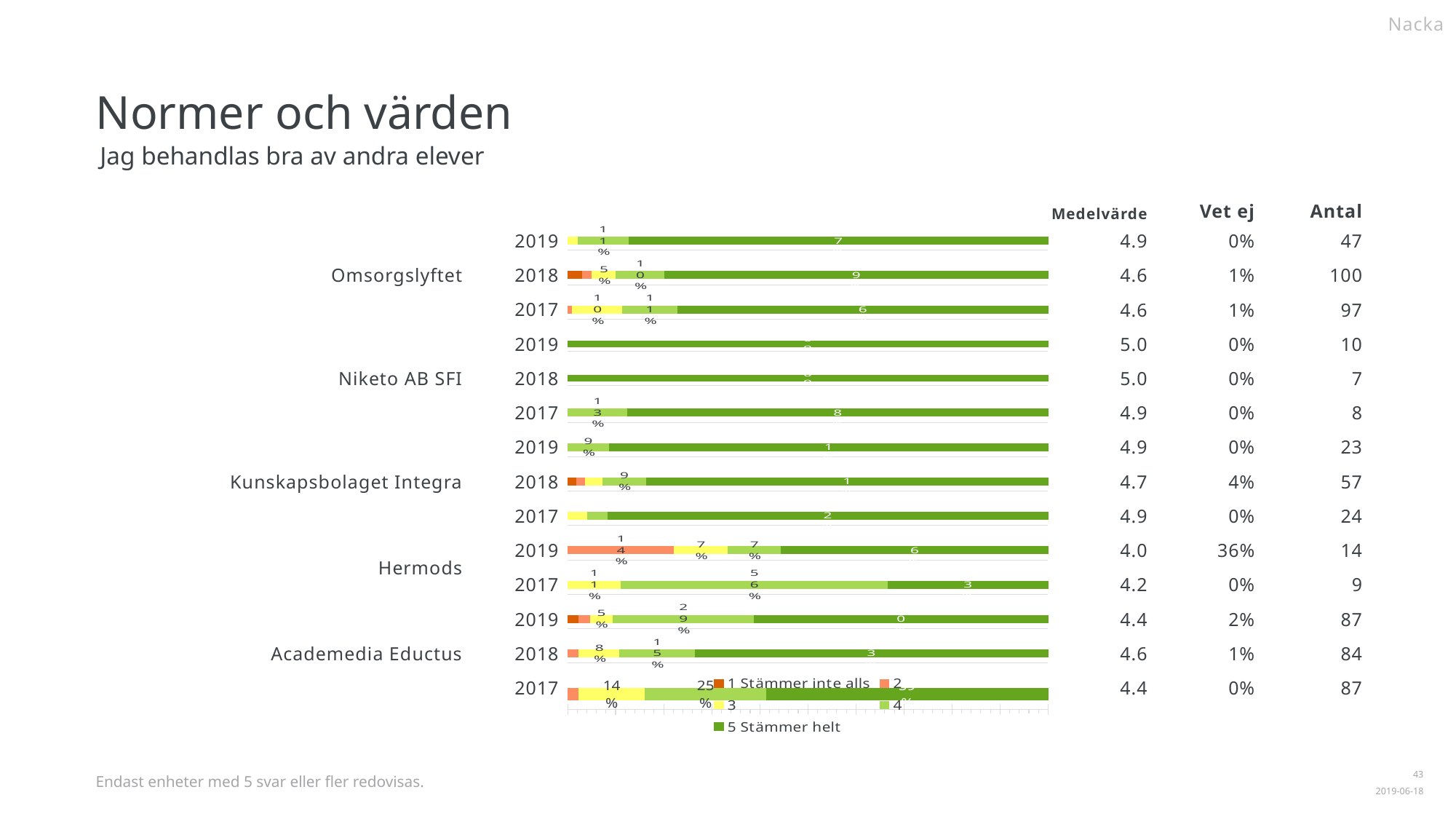
Which is larger: the '4' segment for Hermods 2017 or the '4' segment for Academedia Eductus 2017? Hermods 2017 What is the value of the '4' segment for Academedia Eductus 2019? 29% How many series does the chart legend list? 5 What is the value of the '4' segment for Academedia Eductus 2017? 25% What is the label of the last legend entry in the chart? 5 Stämmer helt What kind of chart is shown on the slide? Stacked bar chart What is the value of the '2' segment for Hermods 2019? 14% What is the difference between the '4' segment for Hermods 2017 (56%) and the '4' segment for Academedia Eductus 2017 (25%)? 31% What is the value of the '4' segment for Hermods 2017? 56% How many bars (unit-year rows) are plotted in the chart? 14 What is the label of the first legend entry in the chart? 1 Stämmer inte alls What is the value of the '3' segment for Academedia Eductus 2017? 14%